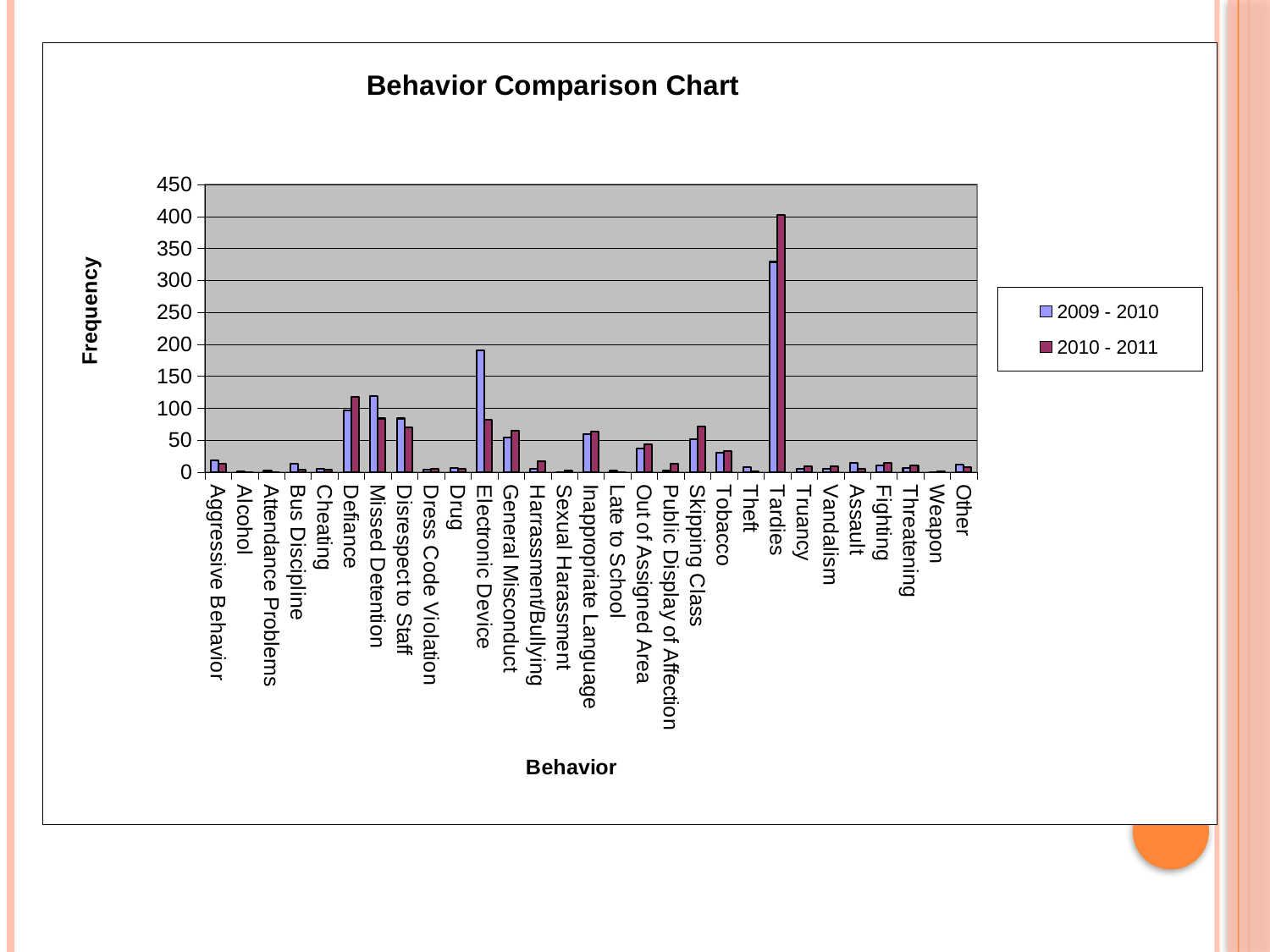
Which behavior has the highest frequency for 2009 - 2010? Tardies How many series does the legend list? 2 Is the 2009 - 2010 value for Electronic Device greater or less than 150? greater For Missed Detention, which series has the larger value, 2009 - 2010 or 2010 - 2011? 2009 - 2010 What is the label of the y axis? Frequency Is the 2010 - 2011 value for Electronic Device greater or less than 100? less What type of chart is the Behavior Comparison Chart? bar chart For Electronic Device, which series has the larger value, 2009 - 2010 or 2010 - 2011? 2009 - 2010 Which behavior has the highest frequency for 2010 - 2011? Tardies Is the 2009 - 2010 value for Tardies greater or less than 300? greater How many behavior categories are shown on the x axis? 29 For Tardies, which series has the larger value, 2009 - 2010 or 2010 - 2011? 2010 - 2011